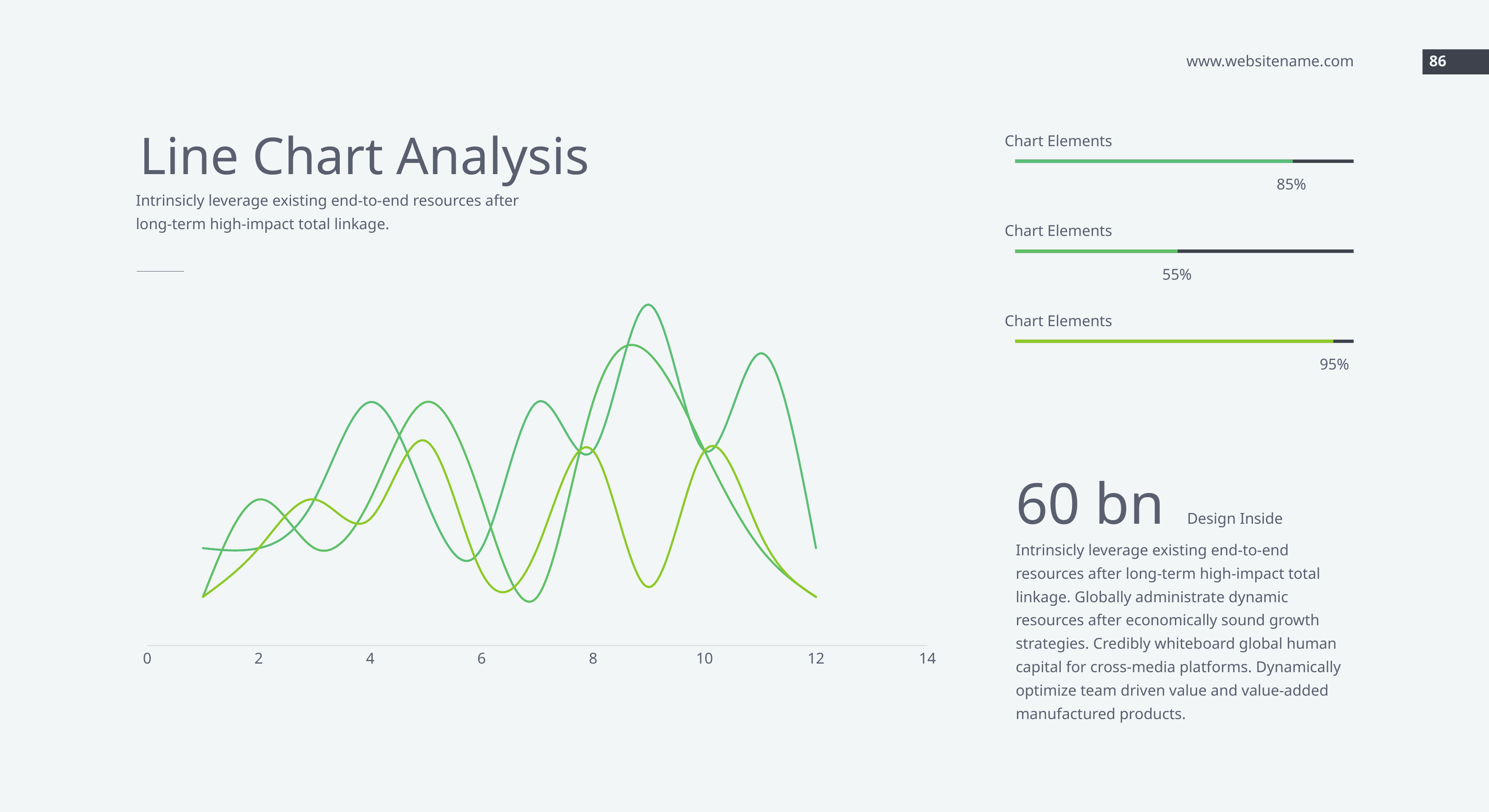
How many lines are plotted on the line chart? 3 What is the highest value labelled on the x axis of the line chart? 14 Do the lines on the chart rise steadily, fall steadily, or fluctuate up and down along the x axis? fluctuate up and down What is the title of the slide containing the line chart? Line Chart Analysis How many tick labels are shown on the x axis of the line chart? 8 Does the line chart display a legend? No What kind of chart is shown on the slide? line chart What is the lowest value labelled on the x axis of the line chart? 0